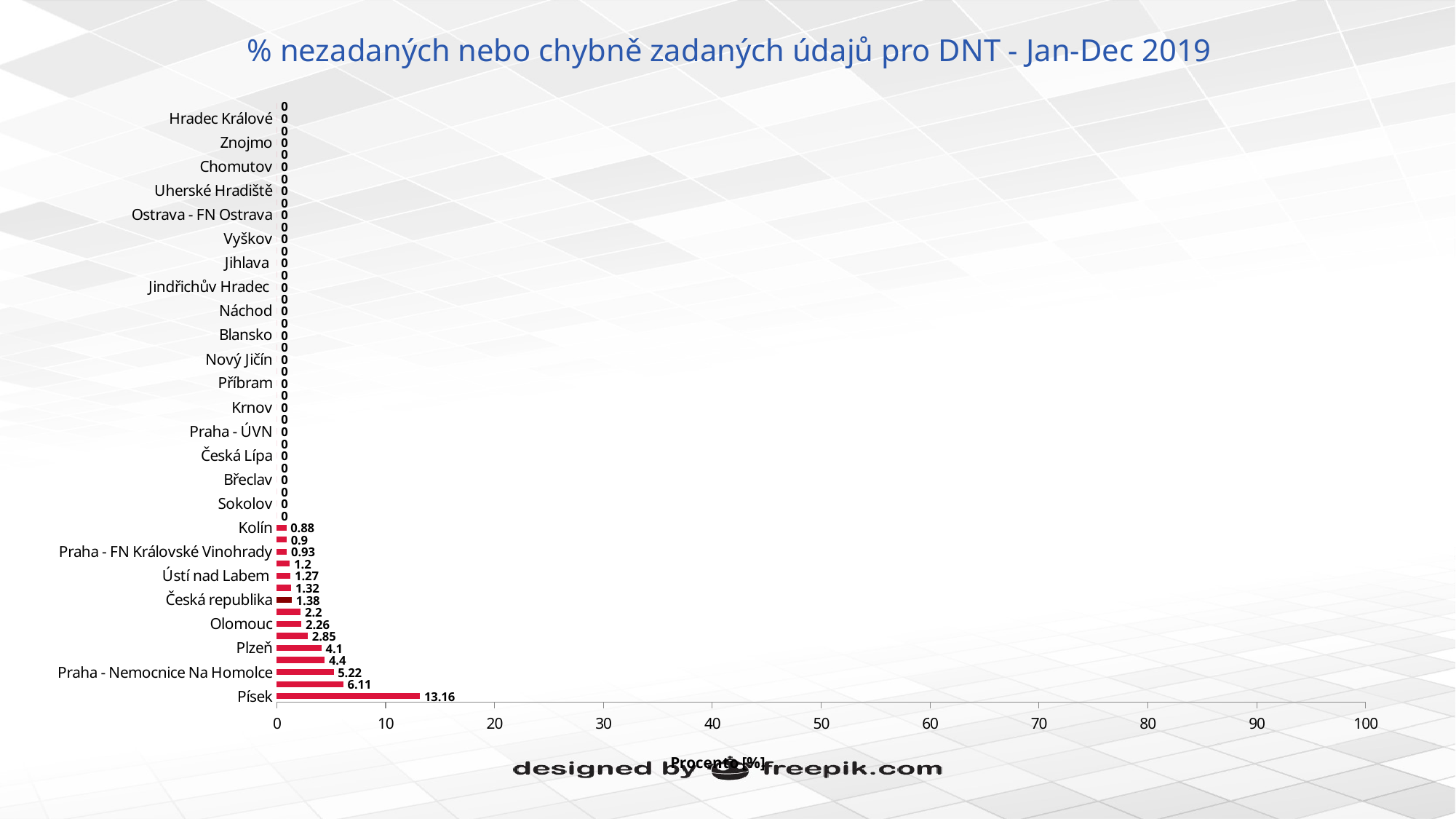
Which category has the highest value? Písek What is the difference between the values for Písek and Praha - Nemocnice Na Homolce? 7.94 What kind of chart is shown on the slide? bar chart What is the value for Písek? 13.16 Which is larger, the value for Ústí nad Labem or the value for Praha - FN Královské Vinohrady? Ústí nad Labem What is the value for Kolín? 0.88 What is the value for Olomouc? 2.26 Is the value for Písek greater or less than 10? greater What is the value for Praha - Nemocnice Na Homolce? 5.22 What is the value for Česká republika? 1.38 What is the difference between the values for Plzeň and Olomouc? 1.84 What is the value for Plzeň? 4.1